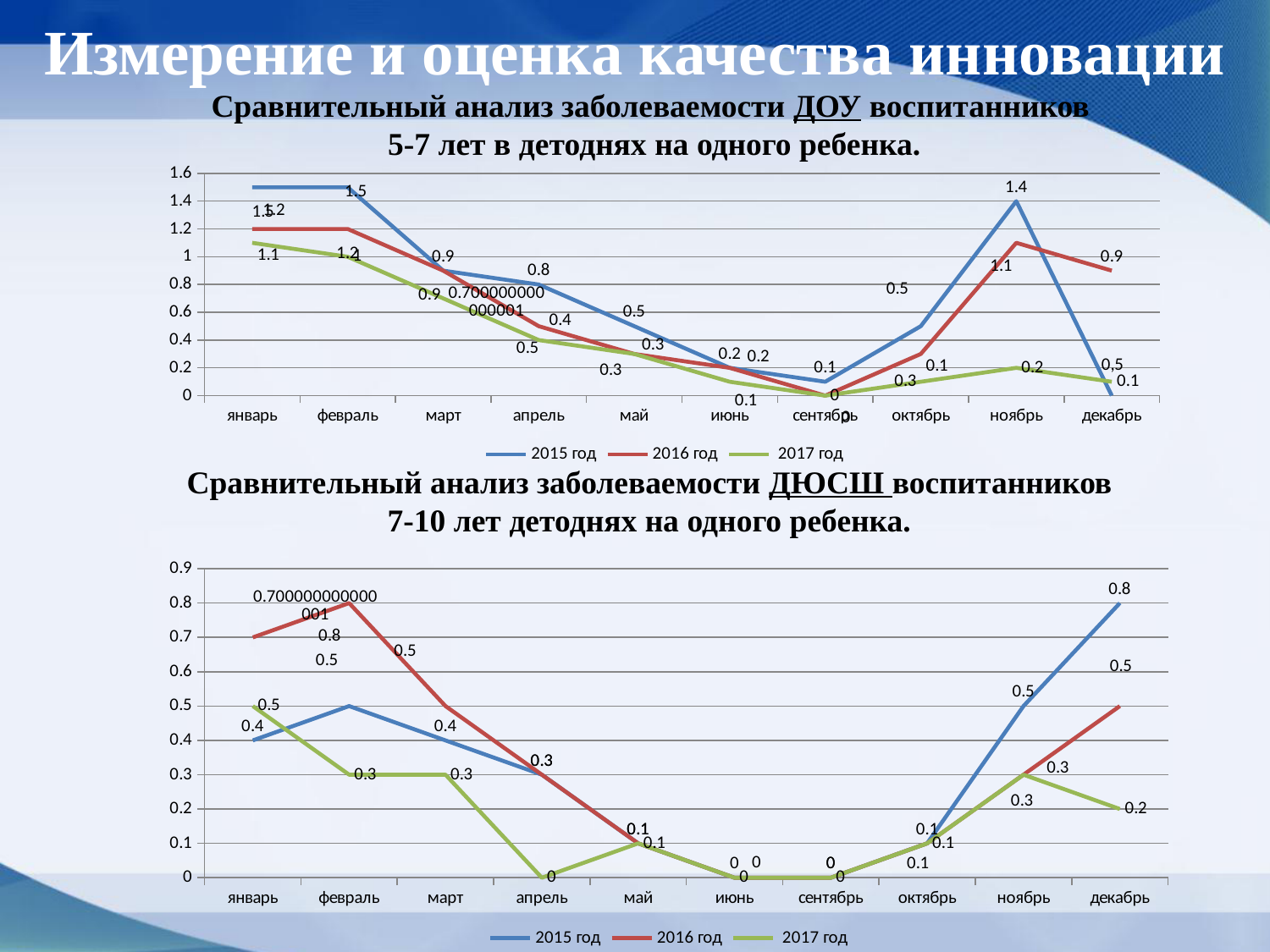
In the bottom chart (ДЮСШ воспитанников 7-10 лет), in which month is the 2015 год value highest? декабрь In the bottom chart (ДЮСШ воспитанников 7-10 лет), what is the difference between the 2015 год and 2017 год values in декабрь? 0.6 In the bottom chart (ДЮСШ воспитанников 7-10 лет), what is the value for 2017 год in декабрь? 0.2 What kind of chart is the bottom chart (ДЮСШ воспитанников 7-10 лет)? line chart In the top chart (ДОУ воспитанников 5-7 лет), what is the value for 2016 год in декабрь? 0.9 In the bottom chart (ДЮСШ воспитанников 7-10 лет), does the 2015 год line rise or fall from октябрь to декабрь? rises In the bottom chart (ДЮСШ воспитанников 7-10 лет), which series has the larger value in декабрь, 2015 год or 2016 год? 2015 год In the top chart (ДОУ воспитанников 5-7 лет), what is the value for 2015 год in ноябрь? 1.4 In the bottom chart (ДЮСШ воспитанников 7-10 лет), what is the value for 2015 год in декабрь? 0.8 In the top chart (ДОУ воспитанников 5-7 лет), is the value for 2017 год in ноябрь greater or less than 0.4? less In the top chart (ДОУ воспитанников 5-7 лет), how many series does the legend list? 3 In the bottom chart (ДЮСШ воспитанников 7-10 лет), how many months are shown on the x axis? 10